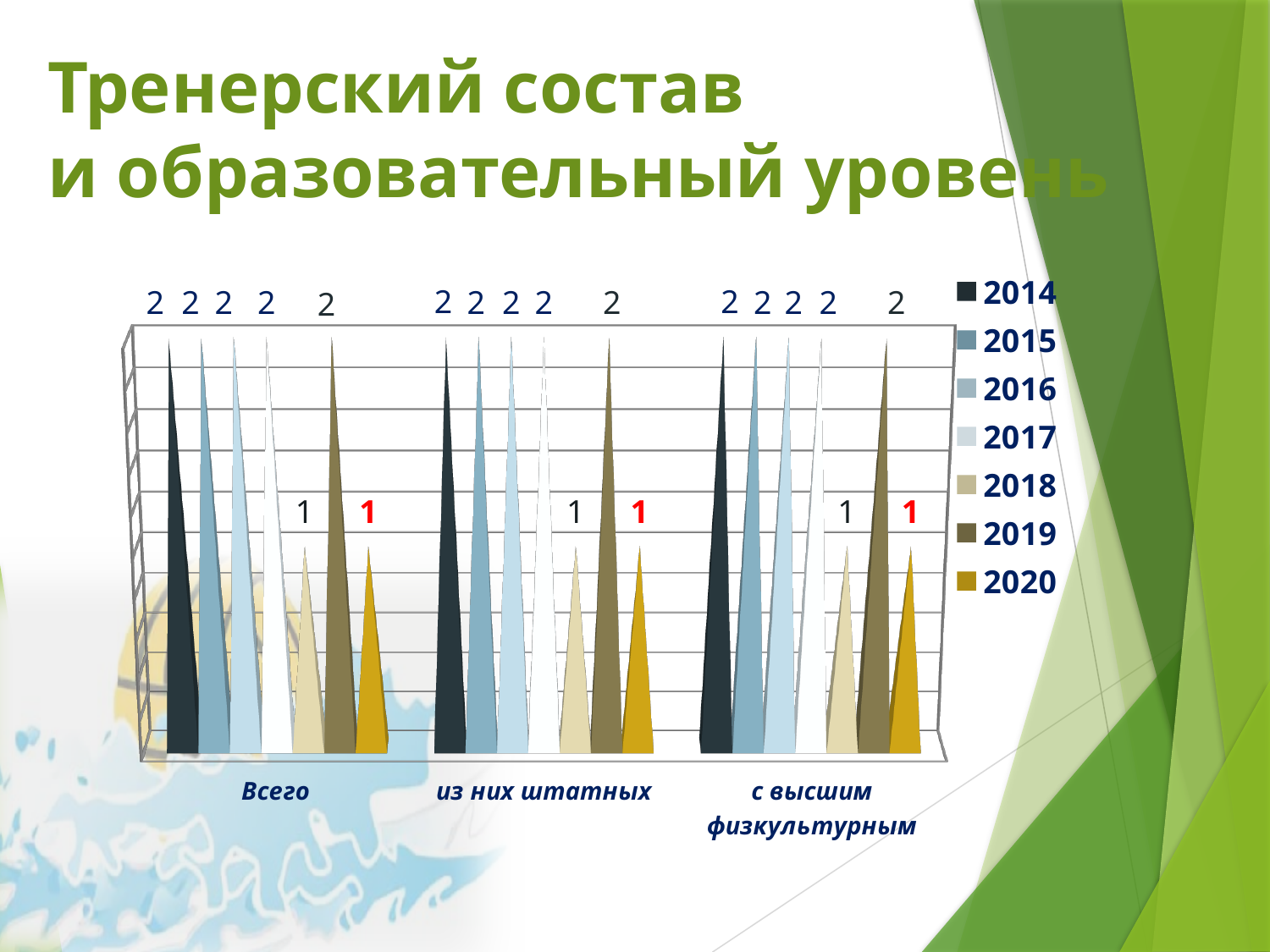
Which is larger in the "Всего" category: the value for 2017 or the value for 2018? 2017 What is the value for 2014 in the "Всего" category? 2 What is the difference between the 2019 value and the 2020 value in the "из них штатных" category? 1 What is the value for 2018 in the "из них штатных" category? 1 How many categories are shown on the x axis? 3 Which year is shown first in the legend? 2014 Which series has the lowest value in the "с высшим физкультурным" category? 2018 and 2020 What is the title of the slide? Тренерский состав и образовательный уровень What is the value for 2020 in the "с высшим физкультурным" category? 1 What kind of chart is shown on the slide? bar chart How many series does the legend list? 7 What is the value for 2019 in the "Всего" category? 2